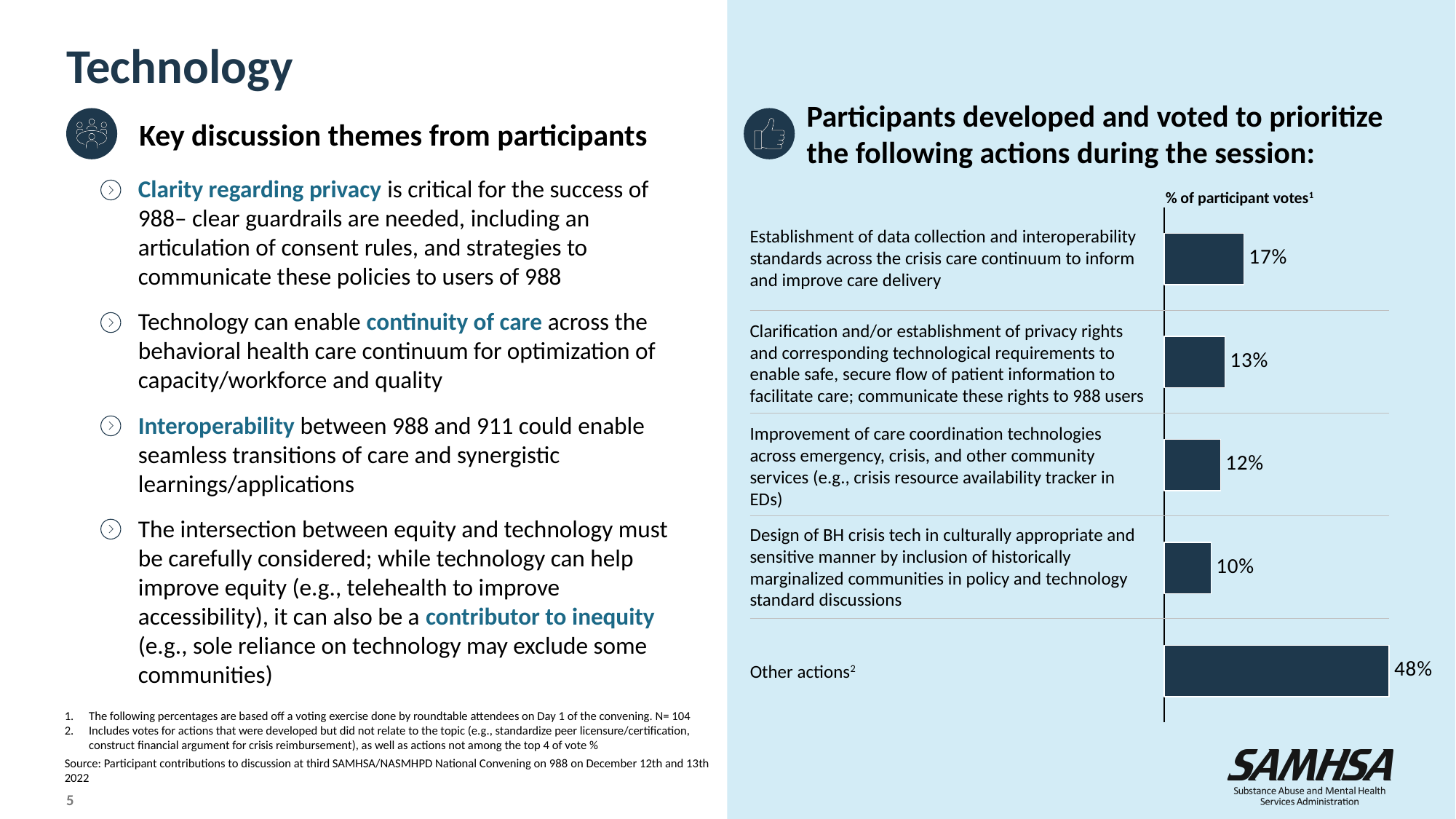
What percentage of participant votes went to establishment of data collection and interoperability standards across the crisis care continuum? 17% What is the label above the bars in the chart? % of participant votes What percentage of participant votes went to design of BH crisis tech in a culturally appropriate and sensitive manner? 10% What percentage of participant votes went to clarification and/or establishment of privacy rights and corresponding technological requirements? 13% How many categories are shown in the bar chart? 5 What type of chart is used to show the % of participant votes? Bar chart What percentage of participant votes went to Other actions? 48% Which category received the highest share of participant votes? Other actions What percentage of participant votes went to improvement of care coordination technologies across emergency, crisis, and other community services? 12% Which category received the lowest share of participant votes? Design of BH crisis tech in culturally appropriate and sensitive manner by inclusion of historically marginalized communities What is the difference in participant votes between establishment of data collection and interoperability standards and clarification of privacy rights? 4% Which received more participant votes: improvement of care coordination technologies or design of BH crisis tech in a culturally appropriate manner? Improvement of care coordination technologies